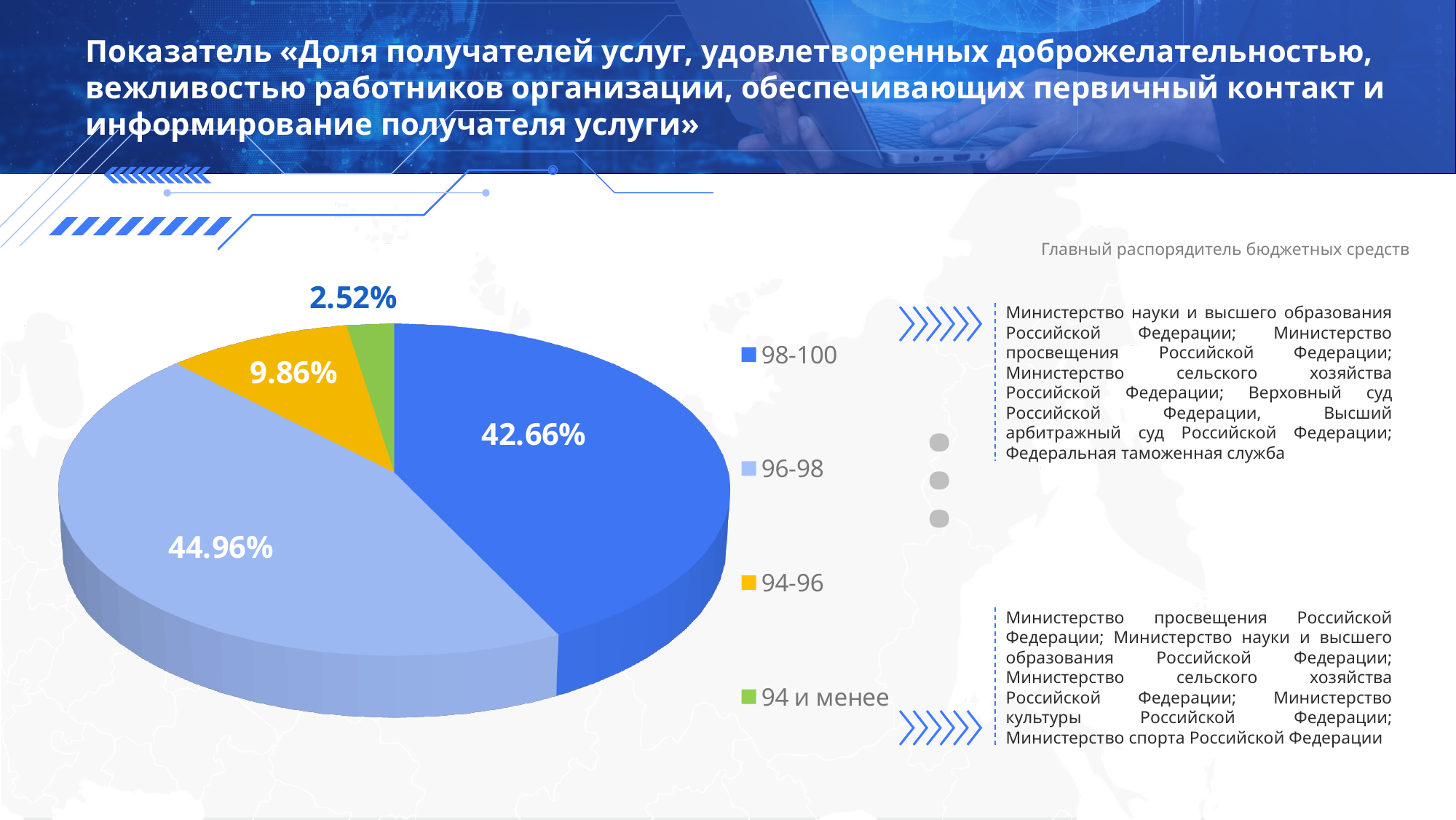
How many categories are shown in the pie chart? 4 What kind of chart is shown on the slide? Pie chart Which category has the smallest slice of the pie? 94 и менее What share of the pie does the 98-100 category have? 42.66% What share of the pie does the 96-98 category have? 44.96% Which is larger, the 94-96 slice or the '94 и менее' slice? 94-96 What colour is the slice for the 94-96 category? Yellow What is the difference in percentage points between the 94-96 slice and the '94 и менее' slice? 7.34 Which category has the largest slice of the pie? 96-98 What is the difference in percentage points between the 96-98 slice and the 98-100 slice? 2.3 What share of the pie does the '94 и менее' category have? 2.52% What share of the pie does the 94-96 category have? 9.86%